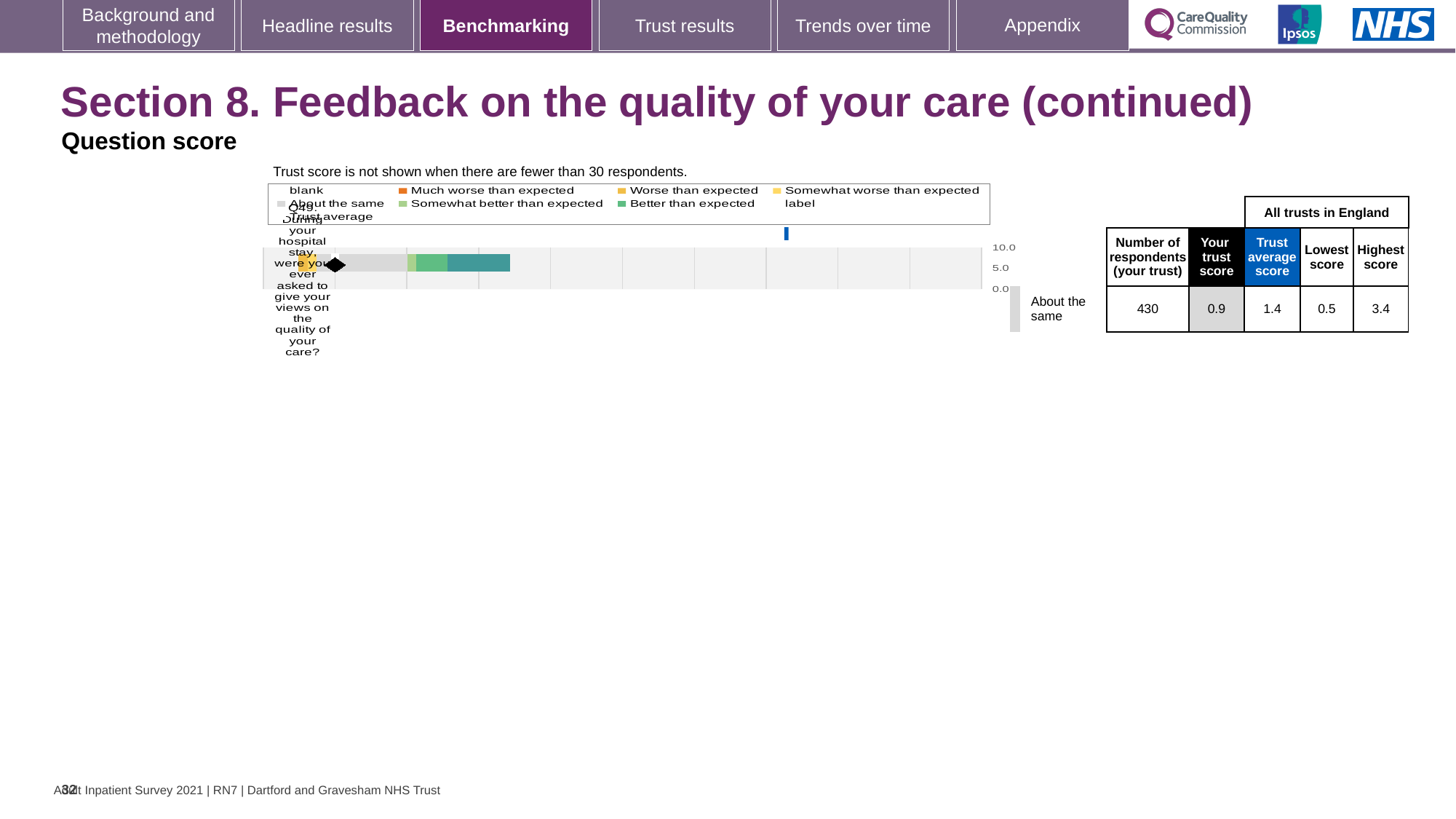
How many questions (categories) are plotted in the benchmarking chart? 1 Which benchmark category is the trust's Q49 result labelled as? About the same Which question is plotted in the benchmarking chart? Q49. During your hospital stay, were you ever asked to give your views on the quality of your care? What kind of chart is used to show the benchmarking result for Q49? bar chart According to the table beside the chart, what is the lowest score among all trusts in England for Q49? 0.5 Which is larger for Q49, the trust's score or the trust average score? trust average score How many respondents from the trust answered Q49? 430 According to the table beside the chart, what is the trust average score for Q49? 1.4 According to the table beside the chart, what is the trust's score for Q49? 0.9 According to the table beside the chart, what is the highest score among all trusts in England for Q49? 3.4 What is the difference between the highest and lowest scores among all trusts in England for Q49? 2.9 What colour does the legend use for 'Much worse than expected'? orange